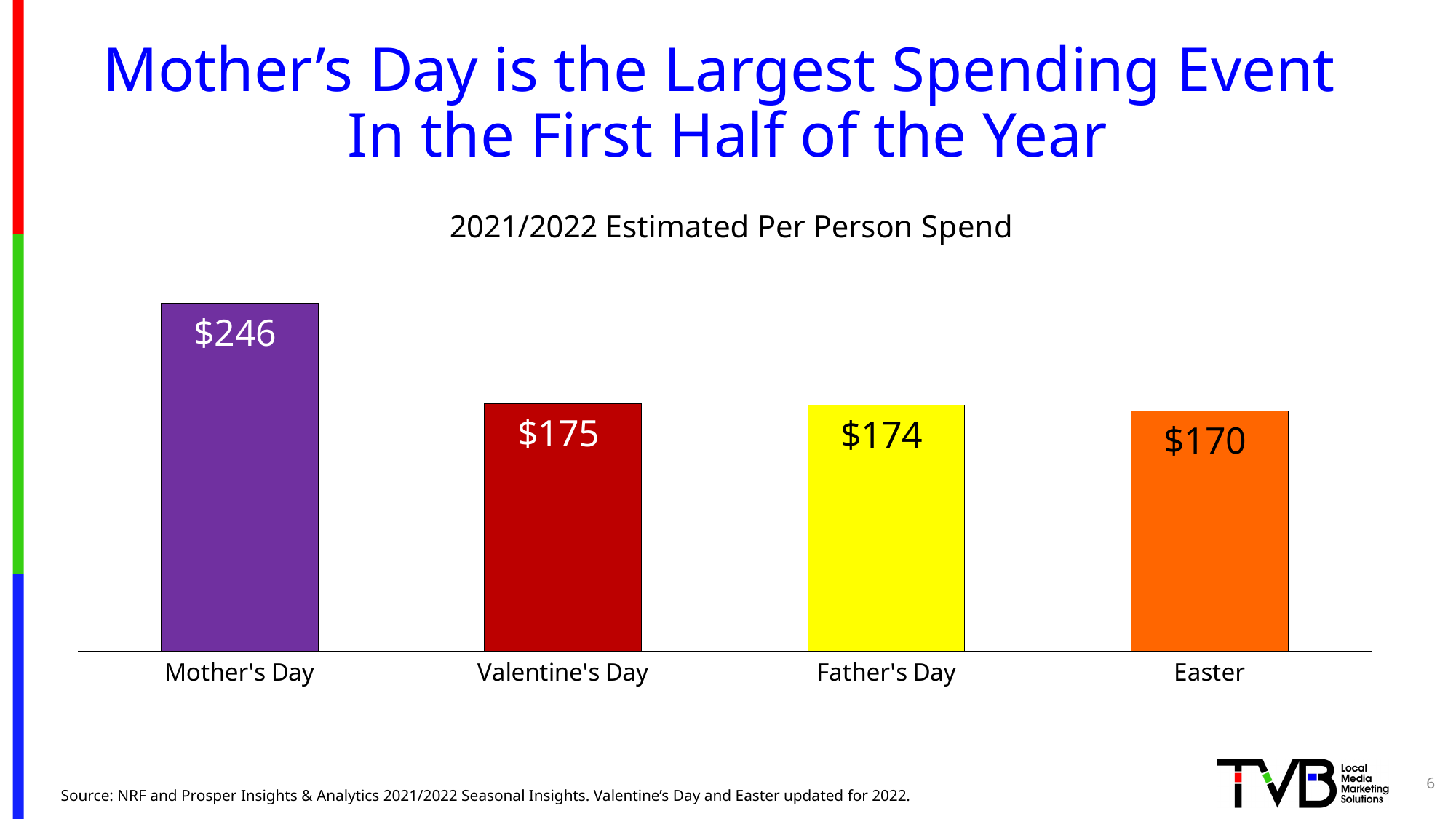
Which event has the lowest estimated per person spend? Easter What is the estimated per person spend for Easter? $170 How much higher is the per person spend for Mother's Day than for Valentine's Day? $71 What is the estimated per person spend for Mother's Day? $246 How many events are shown in the chart? 4 What is the estimated per person spend for Valentine's Day? $175 What type of chart is shown on the slide? Bar chart What is the difference in per person spend between Father's Day and Easter? $4 Which event has the highest estimated per person spend? Mother's Day What is the estimated per person spend for Father's Day? $174 What is the title of the chart? 2021/2022 Estimated Per Person Spend Which has a higher per person spend, Mother's Day or Easter? Mother's Day